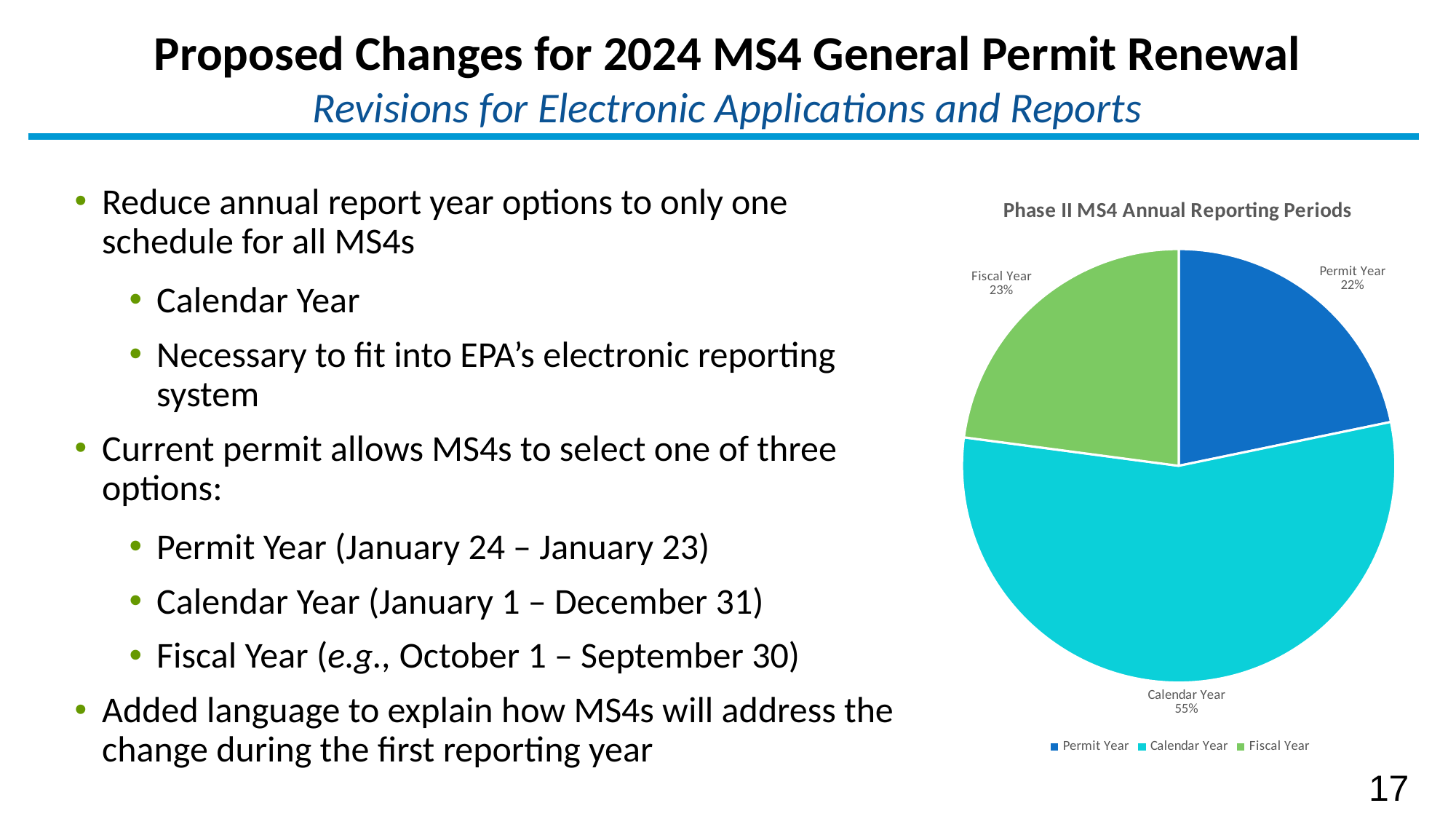
What share of the pie does Calendar Year represent? 55% How many slices does the pie chart have? 3 Which reporting period has the smallest share of the pie? Permit Year What share of the pie does Fiscal Year represent? 23% What is the difference in percentage points between the Calendar Year share and the Fiscal Year share? 32 What share of the pie does Permit Year represent? 22% What kind of chart is shown on the slide? pie chart What is the title of the chart? Phase II MS4 Annual Reporting Periods How many entries does the legend list? 3 Which reporting period has the largest share of the pie? Calendar Year Is the Calendar Year share greater or less than 50%? greater Which is larger, the Fiscal Year share or the Permit Year share? Fiscal Year